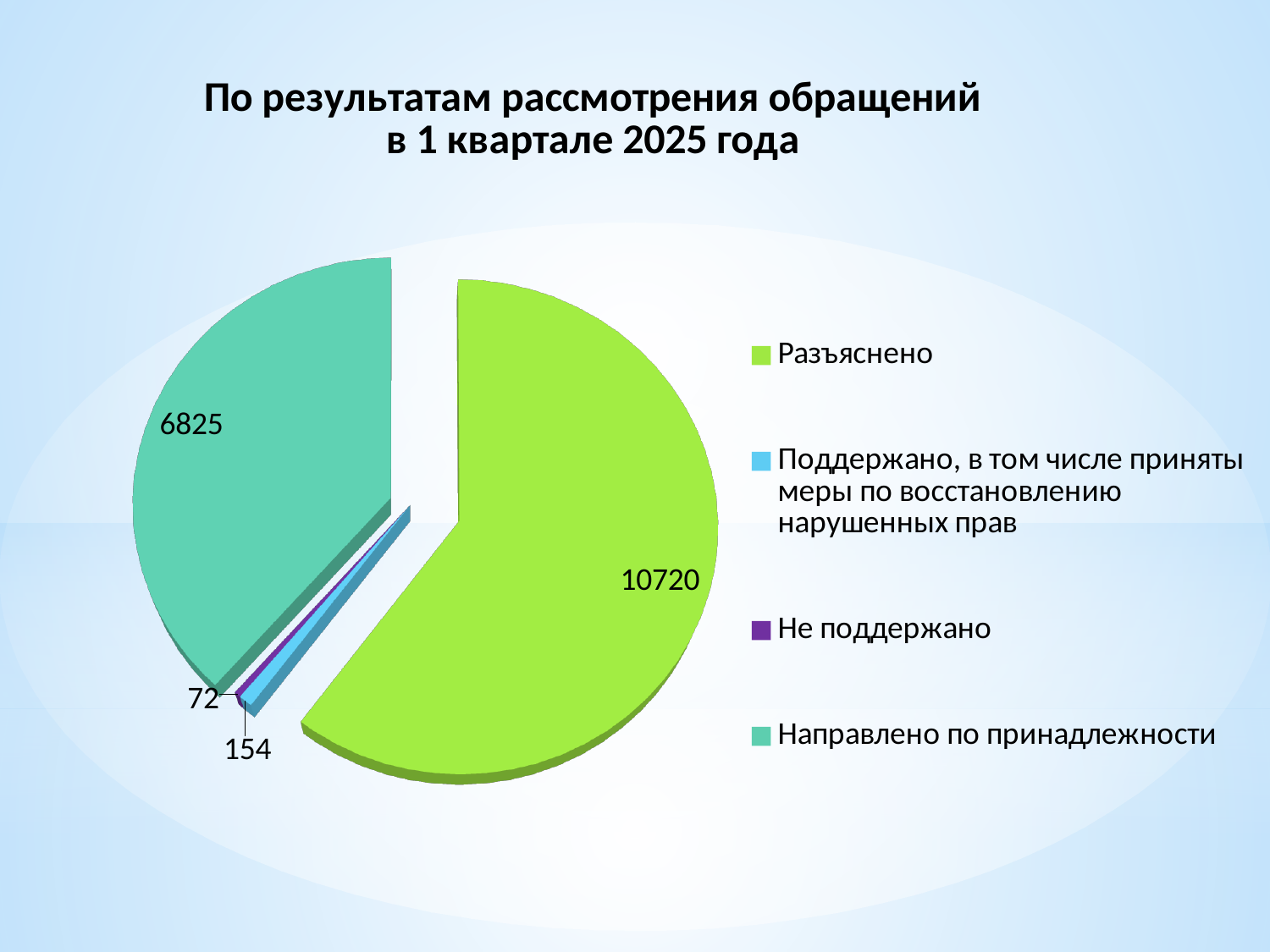
What is the value for Разъяснено? 10720 What colour is the slice for Разъяснено? Green What is the value for Поддержано, в том числе приняты меры по восстановлению нарушенных прав? 154 What is the value for Не поддержано? 72 How many categories are shown in the pie chart? 4 What kind of chart is shown on the slide? Pie chart What is the value for Направлено по принадлежности? 6825 What is the difference between the values for Разъяснено and Направлено по принадлежности? 3895 Which category has the smallest slice of the pie? Не поддержано What is the total of all the values shown in the pie chart? 17771 Which is larger: the value for Поддержано, в том числе приняты меры по восстановлению нарушенных прав or the value for Не поддержано? Поддержано, в том числе приняты меры по восстановлению нарушенных прав Which category has the largest slice of the pie? Разъяснено